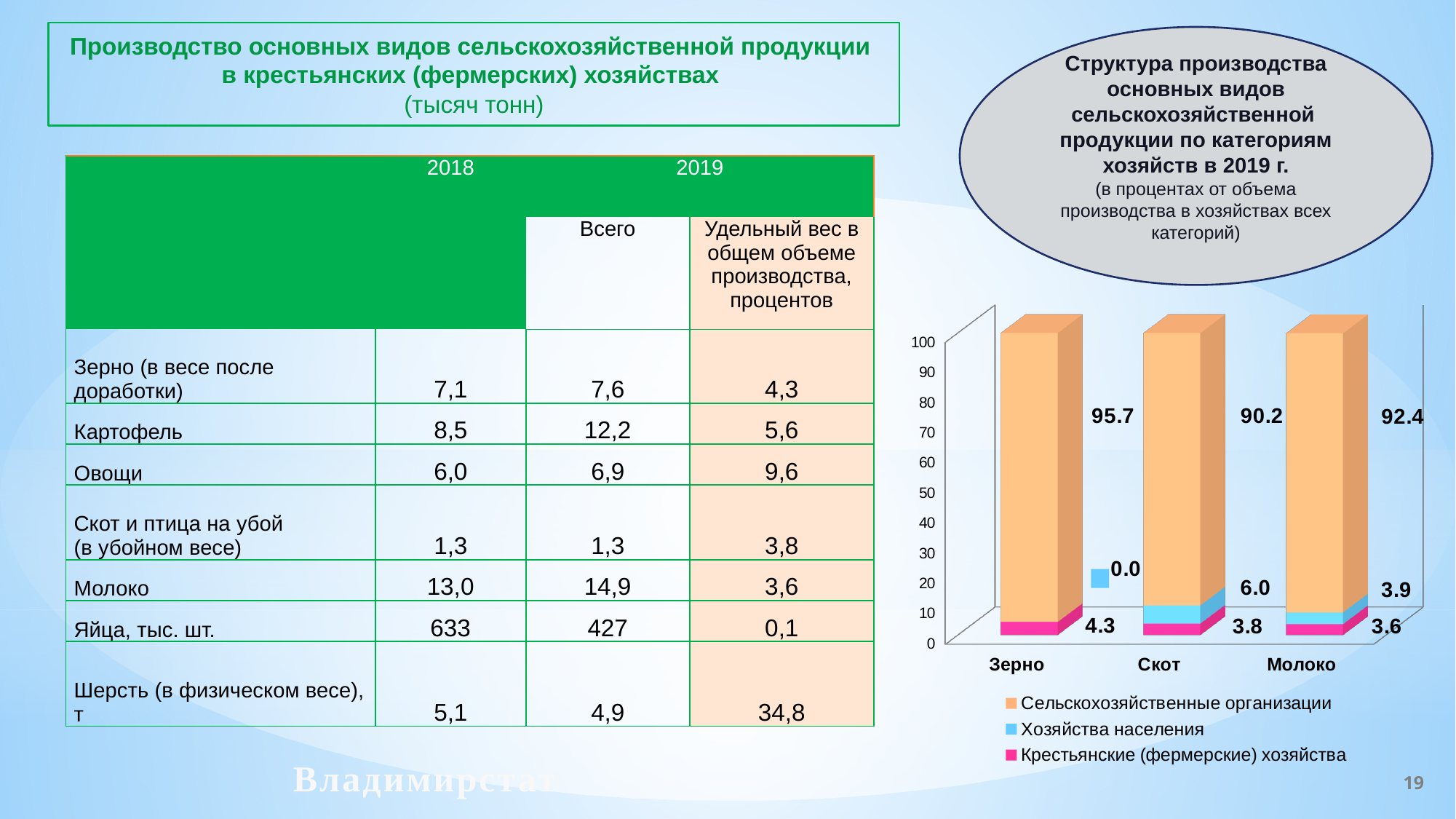
In the chart on the right, which category has the lowest value for Сельскохозяйственные организации? Скот In the chart on the right, which category has the highest value for Крестьянские (фермерские) хозяйства? Зерно How many categories are shown on the x axis of the chart on the right? 3 In the chart on the right, which is larger: the Хозяйства населения value for Скот or for Молоко? Скот In the chart on the right, what is the value for Крестьянские (фермерские) хозяйства for Молоко? 3.6 In the chart on the right, what is the value for Хозяйства населения for Зерно? 0.0 What kind of chart is shown on the right side of the slide? stacked bar chart In the chart on the right, what is the value for Сельскохозяйственные организации for Зерно? 95.7 In the chart on the right, what is the total of the stacked bar for Скот? 100.0 How many series does the legend of the chart on the right list? 3 In the chart on the right, what is the difference between the Сельскохозяйственные организации values for Зерно and Скот? 5.5 In the chart on the right, what is the value for Хозяйства населения for Скот? 6.0